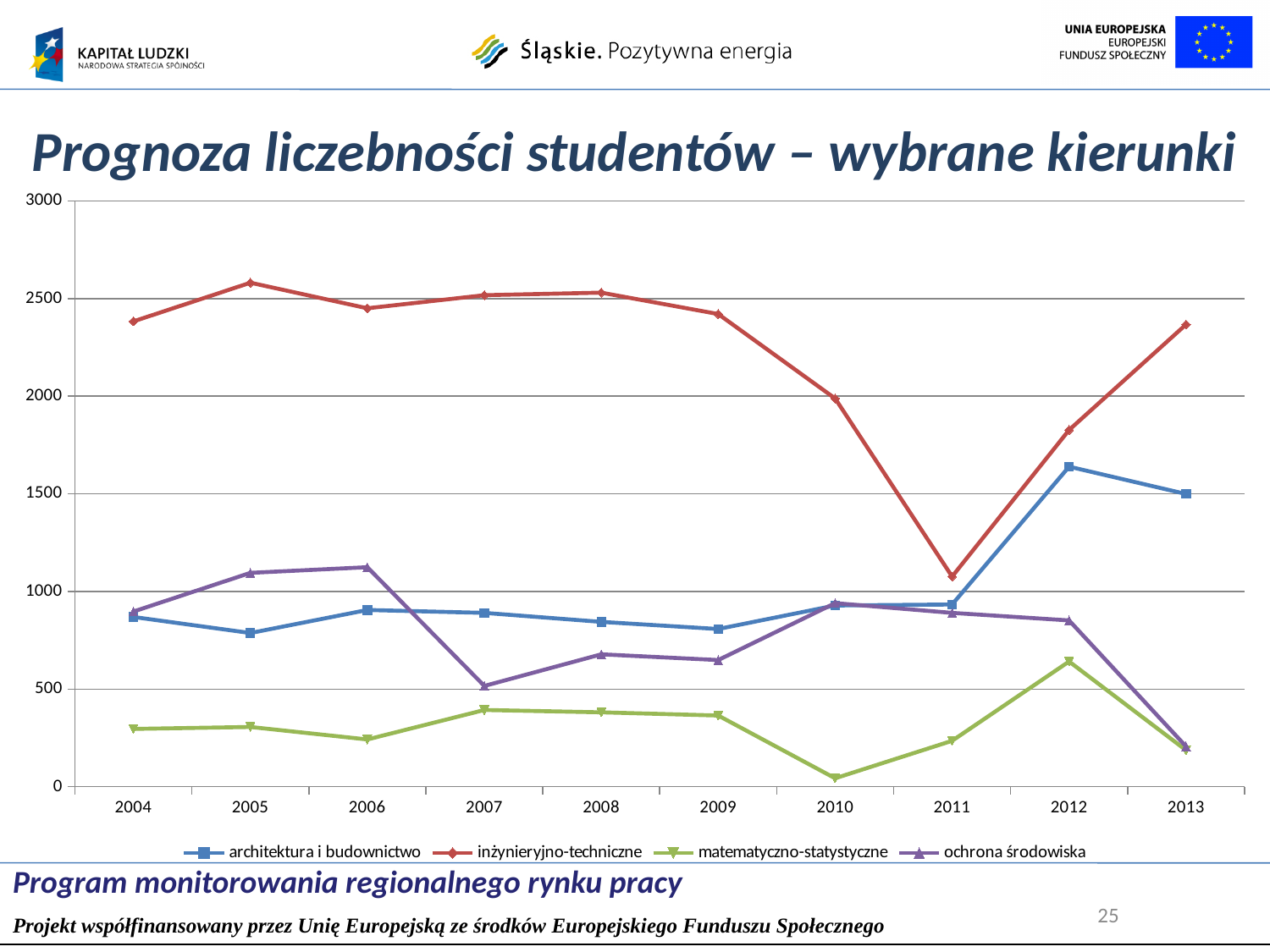
Is the value for architektura i budownictwo in 2012 greater or less than 1500? greater Which series has the highest value in 2004? inżynieryjno-techniczne Does the value for inżynieryjno-techniczne rise or fall from 2009 to 2011? fall How many years are shown on the x axis? 10 What kind of chart is shown on the slide? line chart In 2013, which is larger: architektura i budownictwo or ochrona środowiska? architektura i budownictwo How many series does the legend list? 4 Is the value for matematyczno-statystyczne in 2010 greater or less than 500? less In which year is the value for matematyczno-statystyczne lowest? 2010 In 2006, which is larger: ochrona środowiska or architektura i budownictwo? ochrona środowiska In which year is the value for inżynieryjno-techniczne lowest? 2011 Is the value for inżynieryjno-techniczne in 2011 greater or less than 1500? less